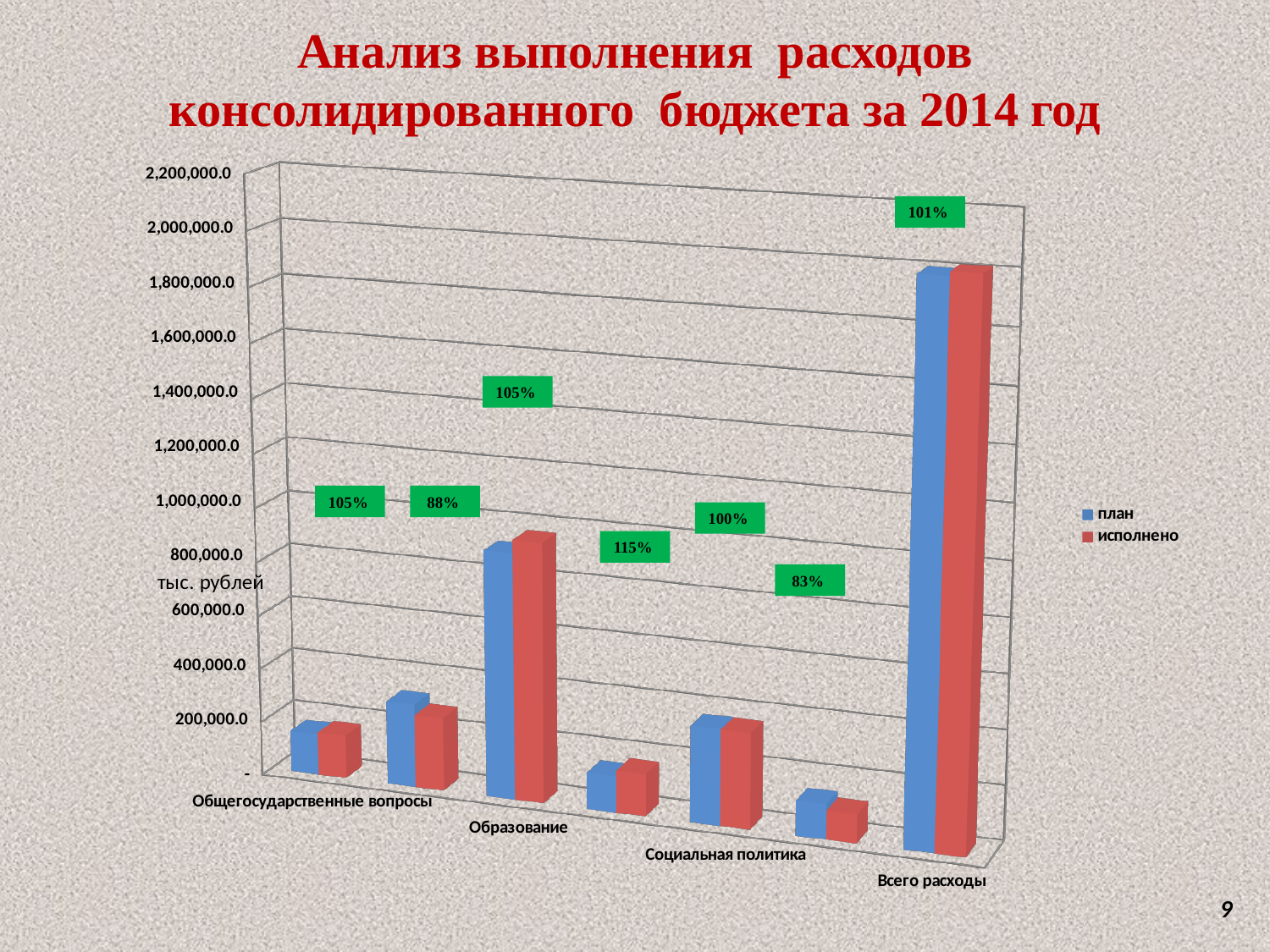
What are the two series named in the legend? план, исполнено Is the план value for Образование greater or less than 600,000.0? greater What execution percentage label is shown above the Всего расходы bars? 101% How many series does the legend list? 2 Is the план value for Социальная политика greater or less than 400,000.0? less What kind of chart is shown on the slide? bar chart What execution percentage label is shown above the Образование bars? 105% Is the план value for Всего расходы greater or less than 1,600,000.0? greater Which category has the tallest bars? Всего расходы Which has the larger план value, Образование or Социальная политика? Образование How many groups of bars are plotted on the chart? 7